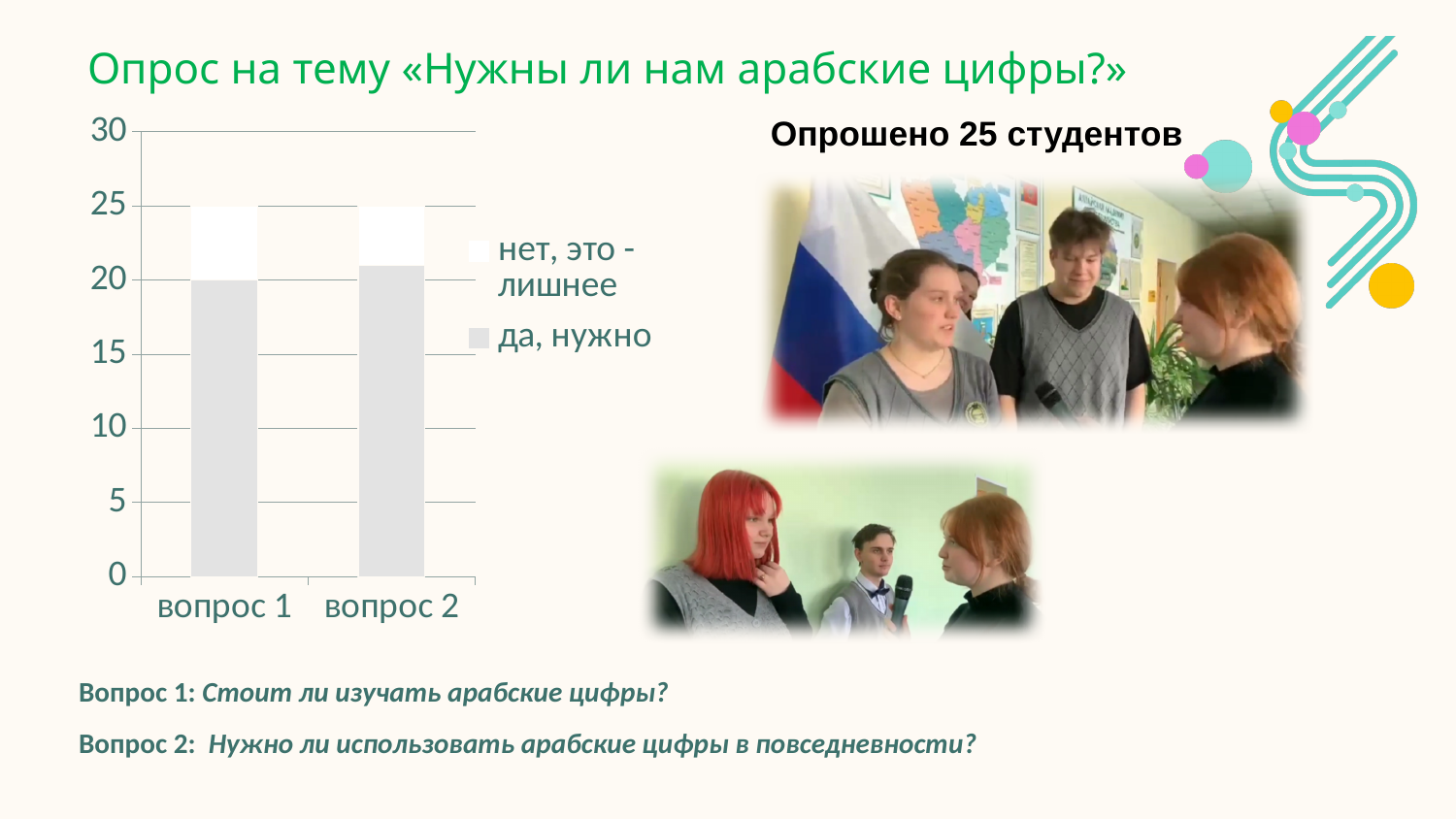
What is the total of the stacked bar for вопрос 2? 25 For вопрос 1, which is larger: "да, нужно" or "нет, это - лишнее"? да, нужно Is the value of "да, нужно" for вопрос 2 greater or less than 15? greater What is the value of "нет, это - лишнее" for вопрос 1? 5 How many categories are shown on the x axis of the chart? 2 For вопрос 1, what is the difference between "да, нужно" and "нет, это - лишнее"? 15 What kind of chart is shown on the slide? bar chart What is the value of "да, нужно" for вопрос 1? 20 Is the value of "да, нужно" for вопрос 2 greater or less than 25? less What is the total of the stacked bar for вопрос 1? 25 Which series in the legend is shown in grey? да, нужно How many series does the chart legend list? 2